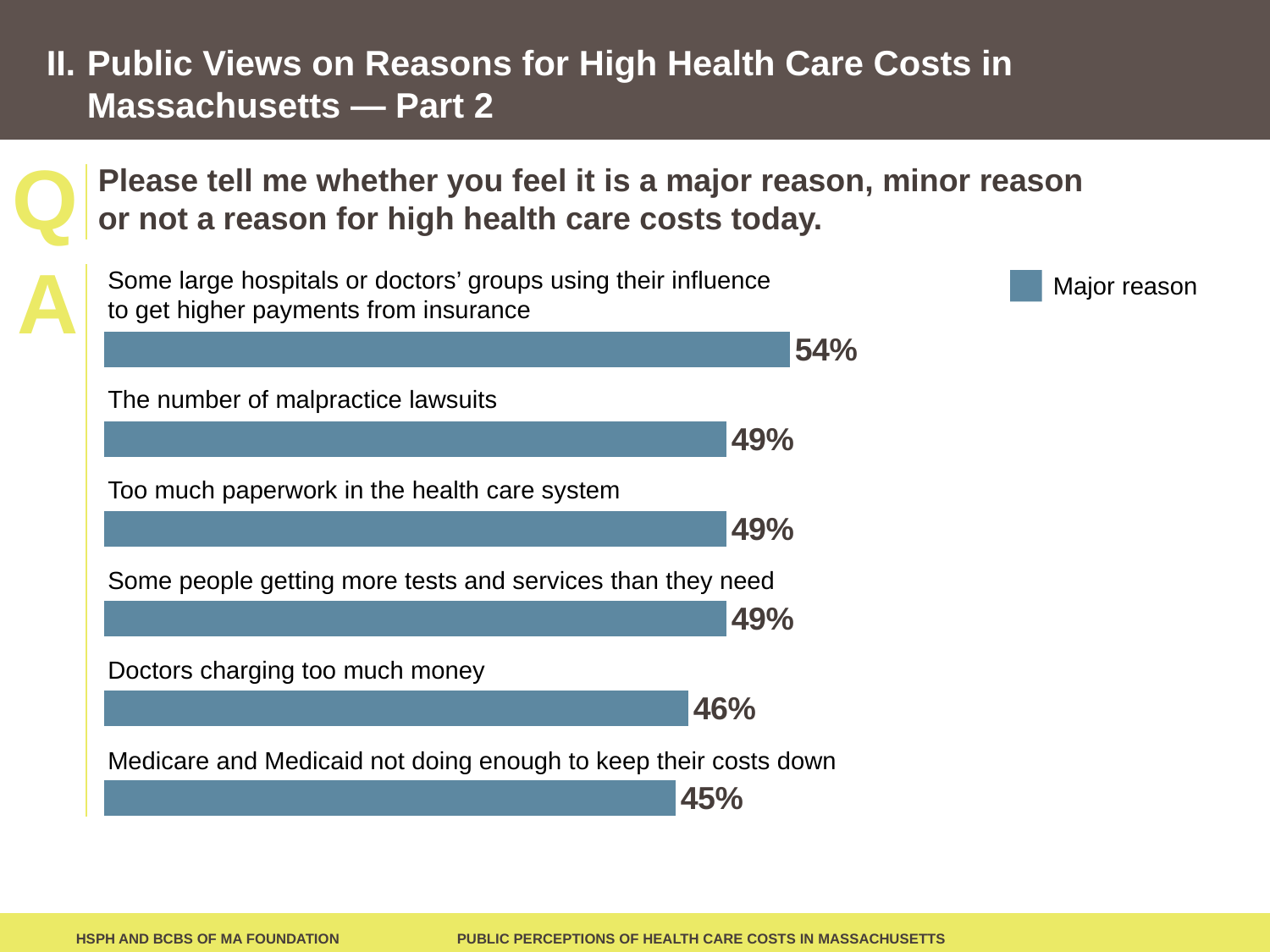
What kind of chart is shown on the slide? Bar chart How many reasons are shown in the chart? 6 What is the difference in percentage points between the value for large hospitals or doctors' groups using their influence and the value for Medicare and Medicaid not doing enough to keep their costs down? 9 What is the legend entry for the bars in the chart? Major reason Which reason has the highest share of respondents calling it a major reason? Some large hospitals or doctors' groups using their influence to get higher payments from insurance Which reason has the lowest share of respondents calling it a major reason? Medicare and Medicaid not doing enough to keep their costs down What percentage said doctors charging too much money is a major reason? 46% How many series does the legend list? 1 What percentage said Medicare and Medicaid not doing enough to keep their costs down is a major reason? 45% Which has a higher value: too much paperwork in the health care system or doctors charging too much money? Too much paperwork in the health care system What percentage said the number of malpractice lawsuits is a major reason? 49% What percentage of respondents said some large hospitals or doctors' groups using their influence to get higher payments from insurance is a major reason? 54%